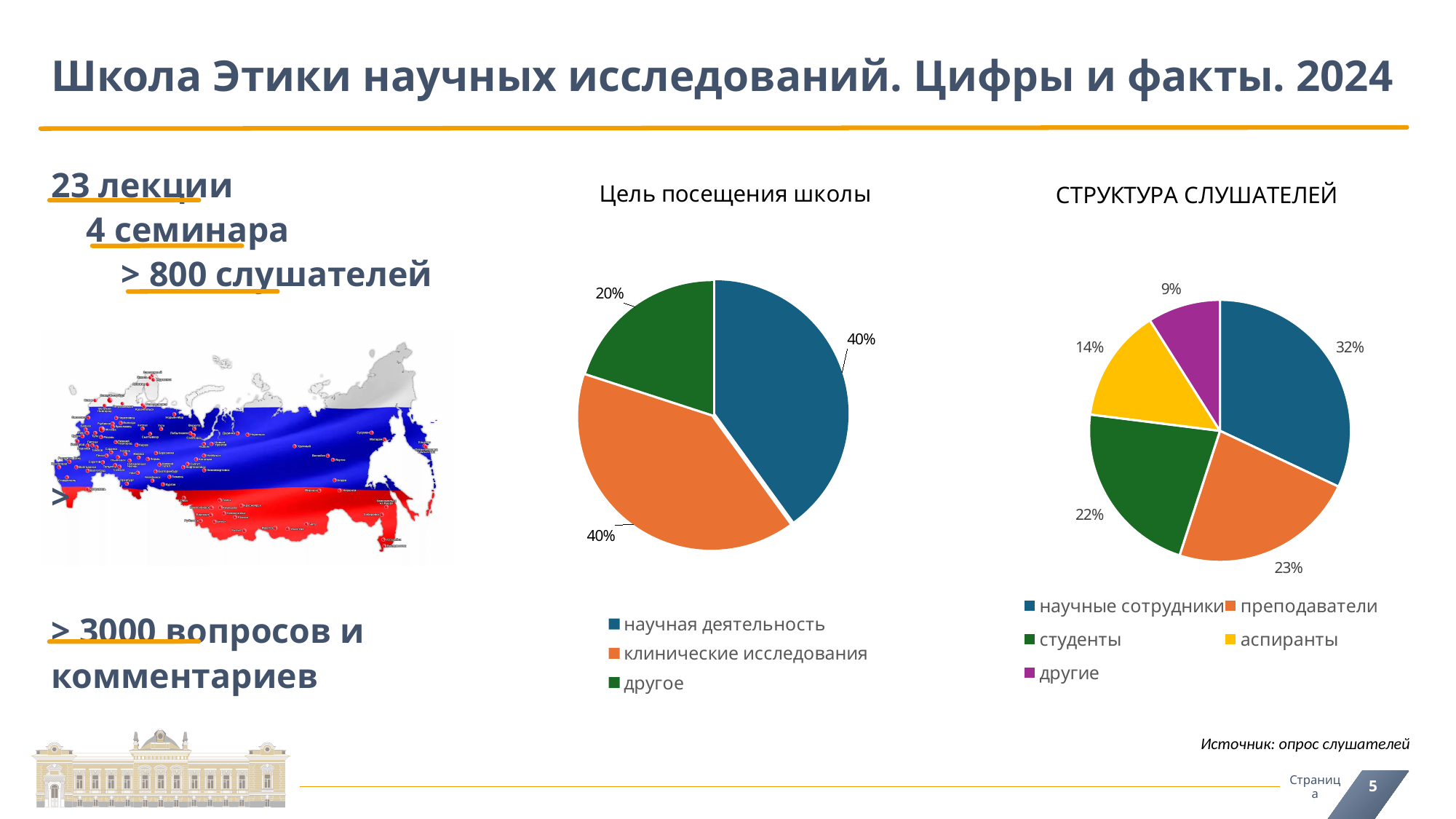
In the chart titled «СТРУКТУРА СЛУШАТЕЛЕЙ», what colour is the slice for «аспиранты»? yellow In the chart titled «Цель посещения школы», which category has the smallest share? другое In the chart titled «СТРУКТУРА СЛУШАТЕЛЕЙ», what share is labelled for «аспиранты»? 14% In the chart titled «СТРУКТУРА СЛУШАТЕЛЕЙ», which category has the largest share? научные сотрудники In the chart titled «СТРУКТУРА СЛУШАТЕЛЕЙ», how many categories does the legend list? 5 In the chart titled «СТРУКТУРА СЛУШАТЕЛЕЙ», what is the difference in percentage points between «научные сотрудники» and «студенты»? 10 In the chart titled «СТРУКТУРА СЛУШАТЕЛЕЙ», what share is labelled for «научные сотрудники»? 32% In the chart titled «Цель посещения школы», what share is labelled for «клинические исследования»? 40% What kind of chart is «Цель посещения школы»? pie chart In the chart titled «Цель посещения школы», how many categories does the legend list? 3 In the chart titled «Цель посещения школы», what share is labelled for «другое»? 20% In the chart titled «СТРУКТУРА СЛУШАТЕЛЕЙ», which category has the smallest share? другие